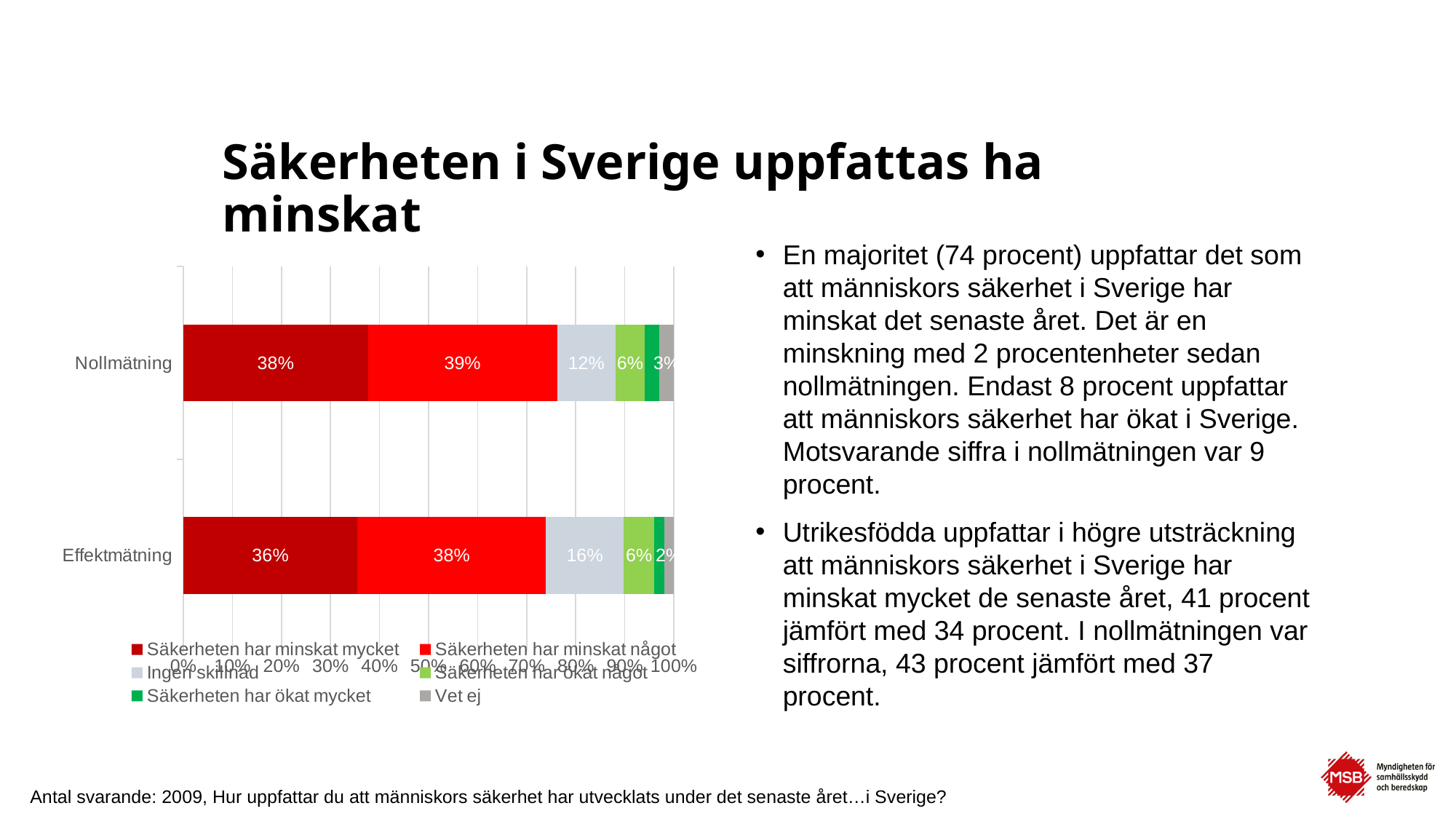
What is the title of the slide containing the chart? Säkerheten i Sverige uppfattas ha minskat Which bar has the larger value for 'Säkerheten har minskat mycket', Nollmätning or Effektmätning? Nollmätning What is the value for 'Ingen skillnad' in the Nollmätning bar? 12% What is the value for 'Säkerheten har minskat något' in the Effektmätning bar? 38% What is the value for 'Ingen skillnad' in the Effektmätning bar? 16% How many series does the legend list? 6 What is the value for 'Säkerheten har minskat mycket' in the Nollmätning bar? 38% What is the value for 'Säkerheten har ökat något' in the Nollmätning bar? 6% How many categories (bars) does the chart show? 2 What is the difference between the 'Ingen skillnad' values for Effektmätning and Nollmätning? 4 percentage points Which series has the largest value in the Effektmätning bar? Säkerheten har minskat något What kind of chart is shown on the slide? Stacked bar chart